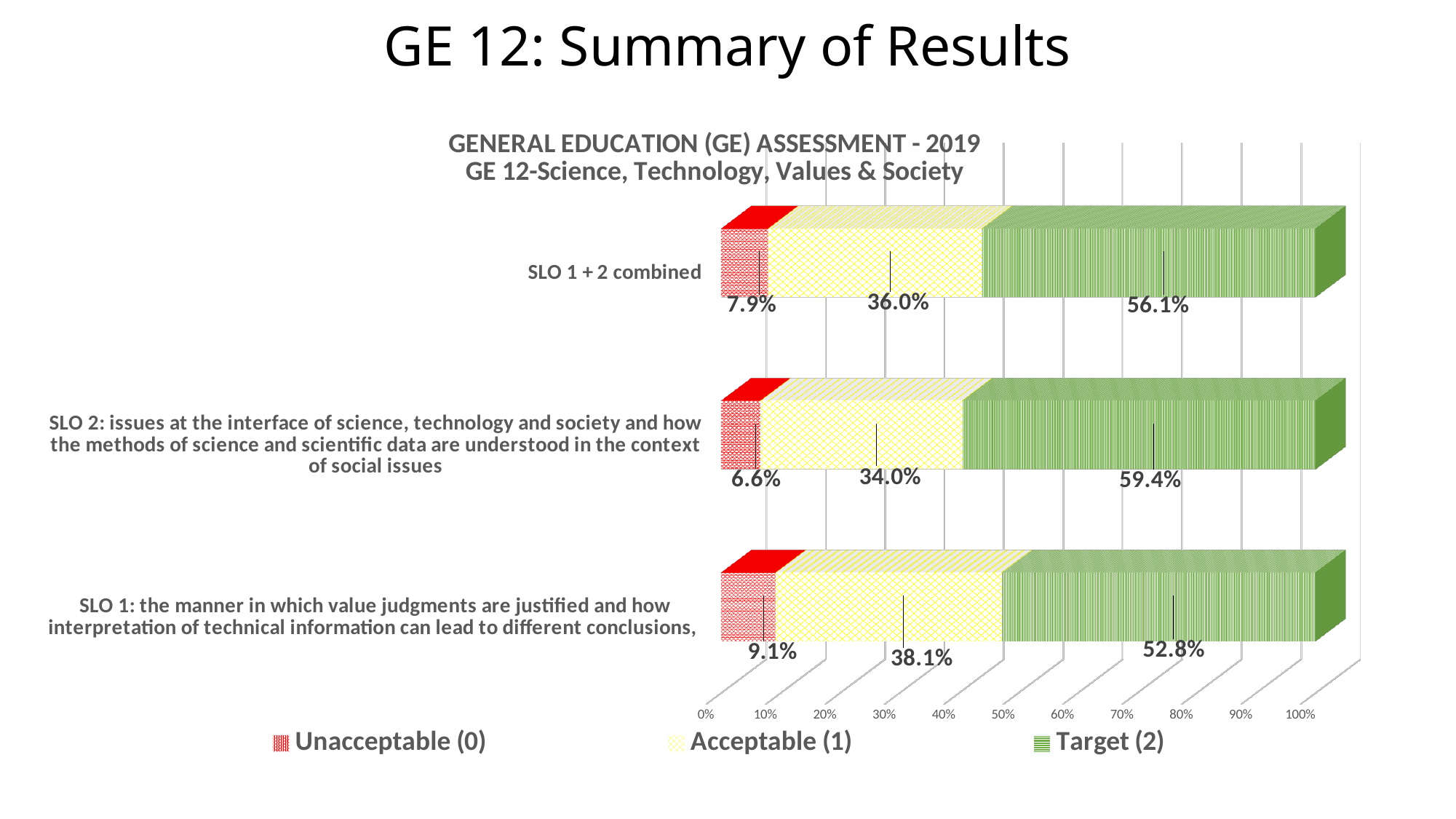
Which colour represents the Target (2) series? Green What kind of chart is shown on the slide? Stacked bar chart Which category has the highest Target (2) value? SLO 2 What is the difference between the Target (2) values for SLO 2 and SLO 1? 6.6% What is the total of the stacked bar for SLO 1 + 2 combined? 100.0% What is the Acceptable (1) value for SLO 1? 38.1% What is the Unacceptable (0) value for SLO 2? 6.6% How many categories are shown on the chart? 3 Which is larger, the Acceptable (1) value for SLO 1 or for SLO 2? SLO 1 How many series does the legend list? 3 Which category has the lowest Unacceptable (0) value? SLO 2 What is the Target (2) value for SLO 1 + 2 combined? 56.1%